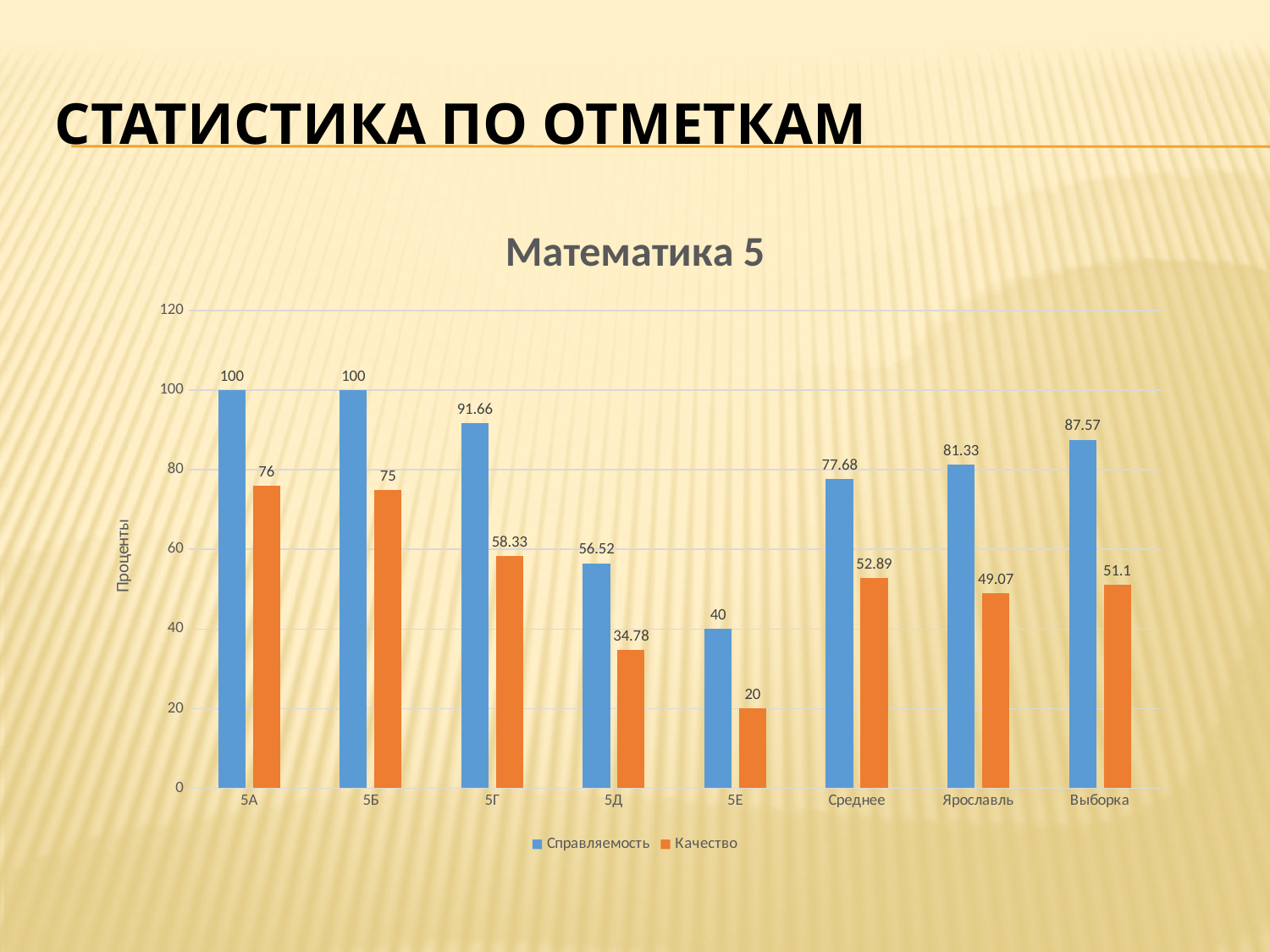
What is the Качество value for 5Е? 20 How many categories are shown on the x axis? 8 Is the Справляемость value for Ярославль greater or less than 80? greater What is the Справляемость value for 5Г? 91.66 Which category has the highest Качество value? 5А What is the Качество value for Ярославль? 49.07 How many series does the legend list? 2 What kind of chart is shown on the slide? bar chart What is the difference between Справляемость and Качество for 5Д? 21.74 What is the title of the chart? Математика 5 Which is larger, the Качество value for Среднее or for Выборка? Среднее Which category has the lowest Справляемость value? 5Е